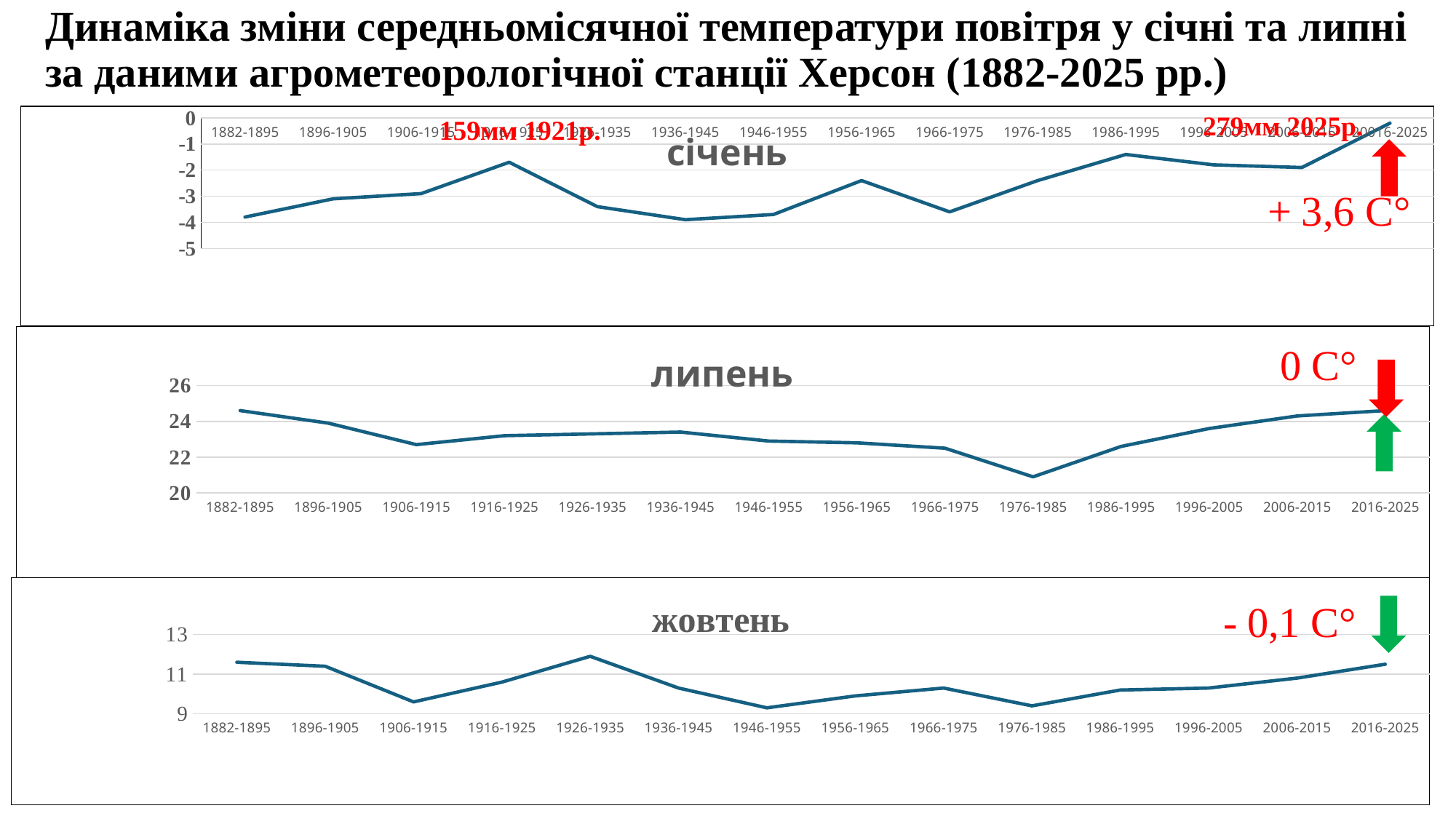
In the "січень" chart, which period has the highest value? 2016-2025 In the "липень" chart, how many period categories are shown on the x axis? 14 In the "січень" chart, is the value for 1882-1895 greater or less than -3? less In the "липень" chart, which period has the lowest value? 1976-1985 In the "липень" chart, is the value for 1976-1985 greater or less than 22? less In the "січень" chart, is the value for 1916-1925 greater or less than -2? greater How many charts are shown on the slide? 3 What kind of chart is the "січень" chart at the top of the slide? line chart In the "жовтень" chart, which is larger: the value for 1926-1935 or the value for 1946-1955? 1926-1935 What temperature change is annotated in red next to the arrow on the "січень" chart? + 3,6 C°